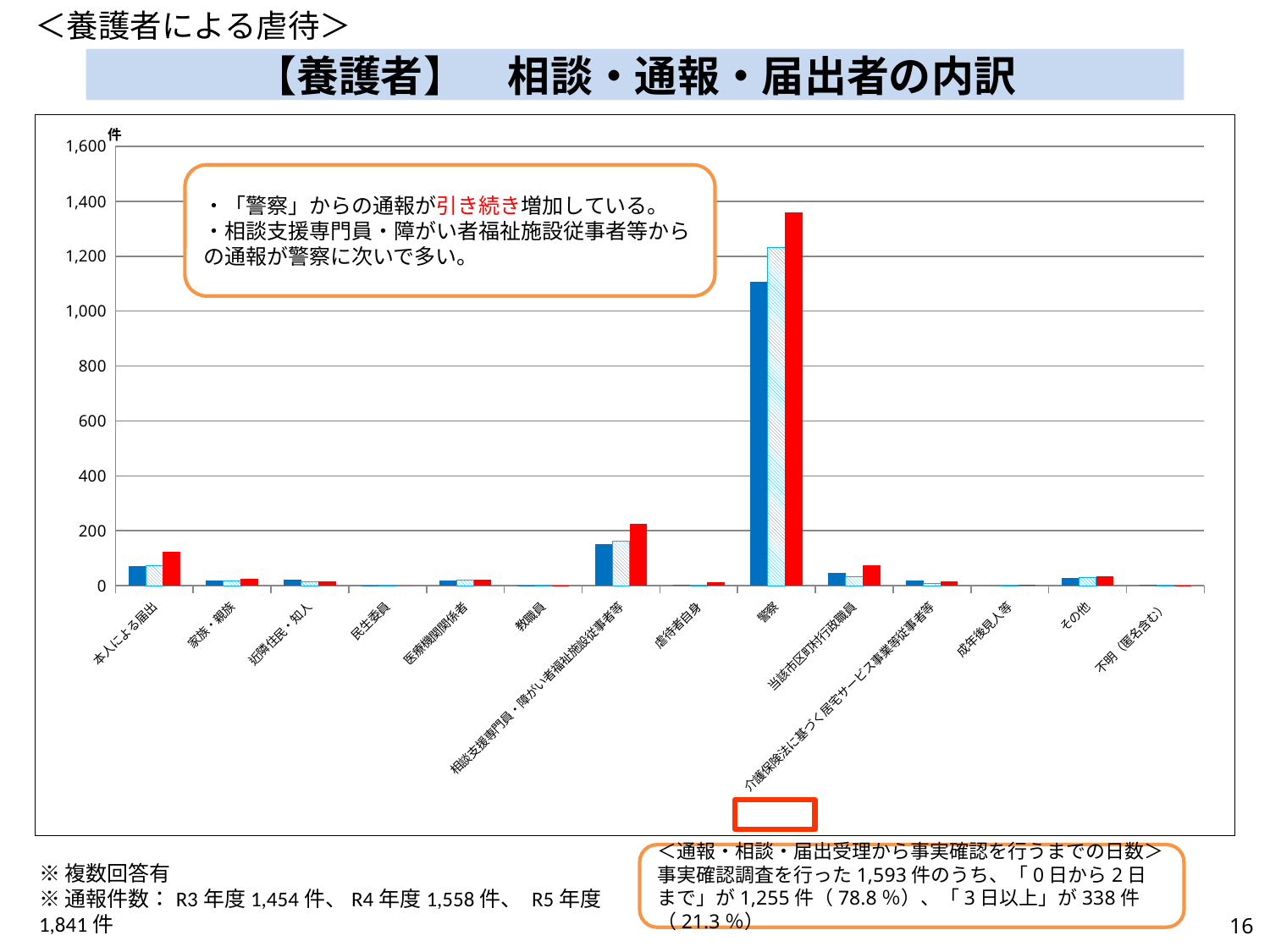
What is the title of the chart? 【養護者】 相談・通報・届出者の内訳 What is the highest value shown on the y axis of the chart? 1,600 Is the value of the red bar for 本人による届出 greater or less than 200? less Is the value of the tallest (red) bar for 警察 greater or less than 1,200? greater Which category has the highest bars in the chart? 警察 Which category has larger values, 本人による届出 or 家族・親族? 本人による届出 Which category has larger values, 警察 or 相談支援専門員・障がい者福祉施設従事者等? 警察 Do the three bars for 警察 rise or fall from left to right? rise Is the value of the red bar for 相談支援専門員・障がい者福祉施設従事者等 greater or less than 400? less What kind of chart is shown on the slide? bar chart How many categories are shown along the x axis of the chart? 14